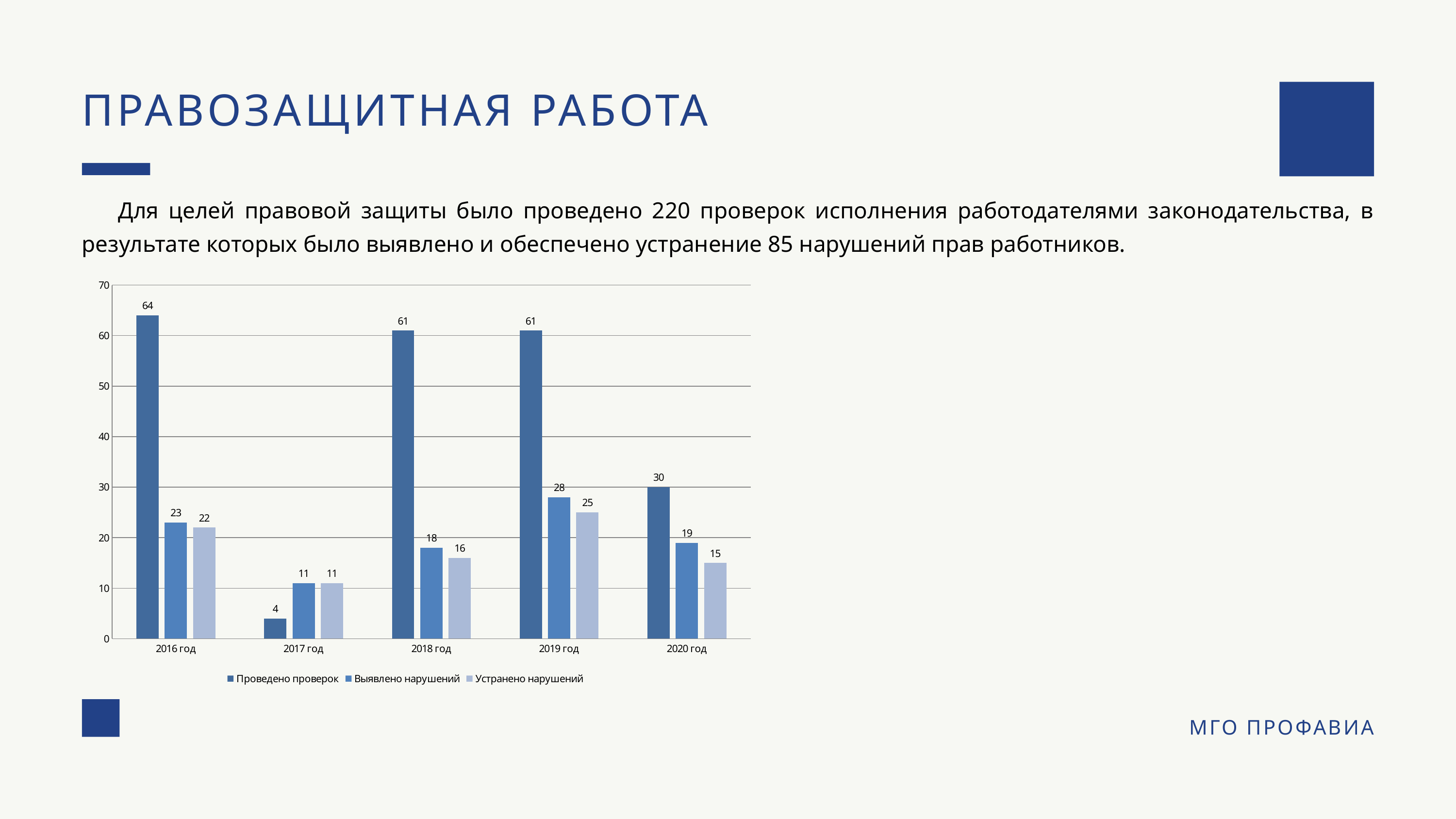
Does the value of "Проведено проверок" rise or fall from 2019 год to 2020 год? Fall How many years are shown on the x axis? 5 Which is larger: "Проведено проверок" for 2020 год or "Выявлено нарушений" for 2019 год? Проведено проверок for 2020 год What is the name of the third series in the legend? Устранено нарушений What is the difference between "Выявлено нарушений" and "Устранено нарушений" for 2019 год? 3 What is the value of "Устранено нарушений" for 2020 год? 15 What kind of chart is shown on the slide? Bar chart What is the value of "Проведено проверок" for 2016 год? 64 Which year has the highest value for "Выявлено нарушений"? 2019 год Which year has the lowest value for "Проведено проверок"? 2017 год What is the value of "Выявлено нарушений" for 2019 год? 28 How many series does the legend list? 3